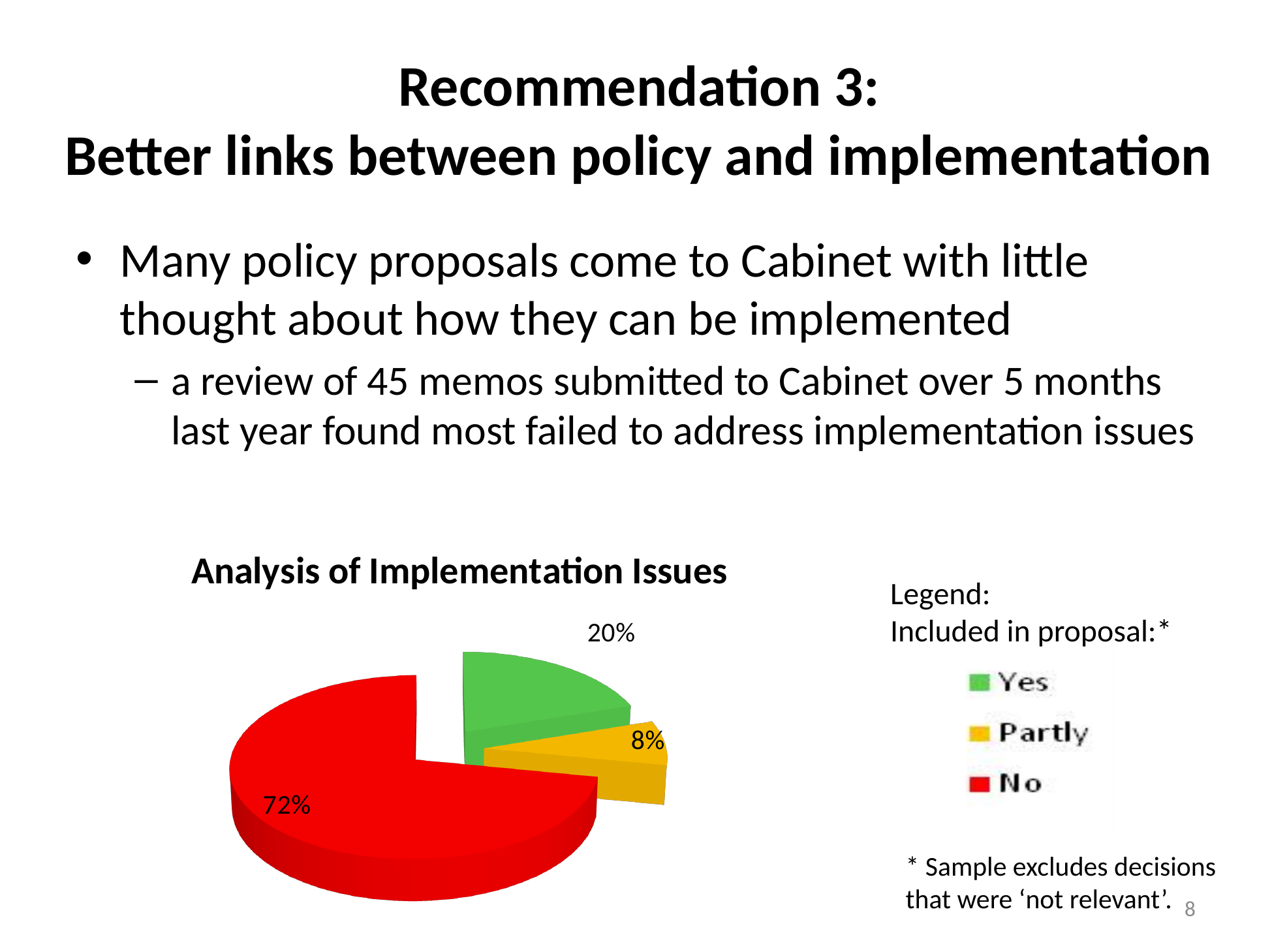
What is the combined share of the 'Yes' and 'Partly' slices? 28% What is the title of the chart? Analysis of Implementation Issues What kind of chart is shown on the slide? pie chart What share of the pie is the 'Partly' slice? 8% Which is larger, the 'Yes' slice or the 'Partly' slice? Yes Which category has the largest slice of the pie? No What share of the pie is the 'No' slice? 72% What is the difference in percentage points between the 'No' slice and the 'Yes' slice? 52 What share of the pie is the 'Yes' slice? 20% How many slices does the pie chart have? 3 What colour is the 'No' slice in the pie chart? red Which category has the smallest slice of the pie? Partly